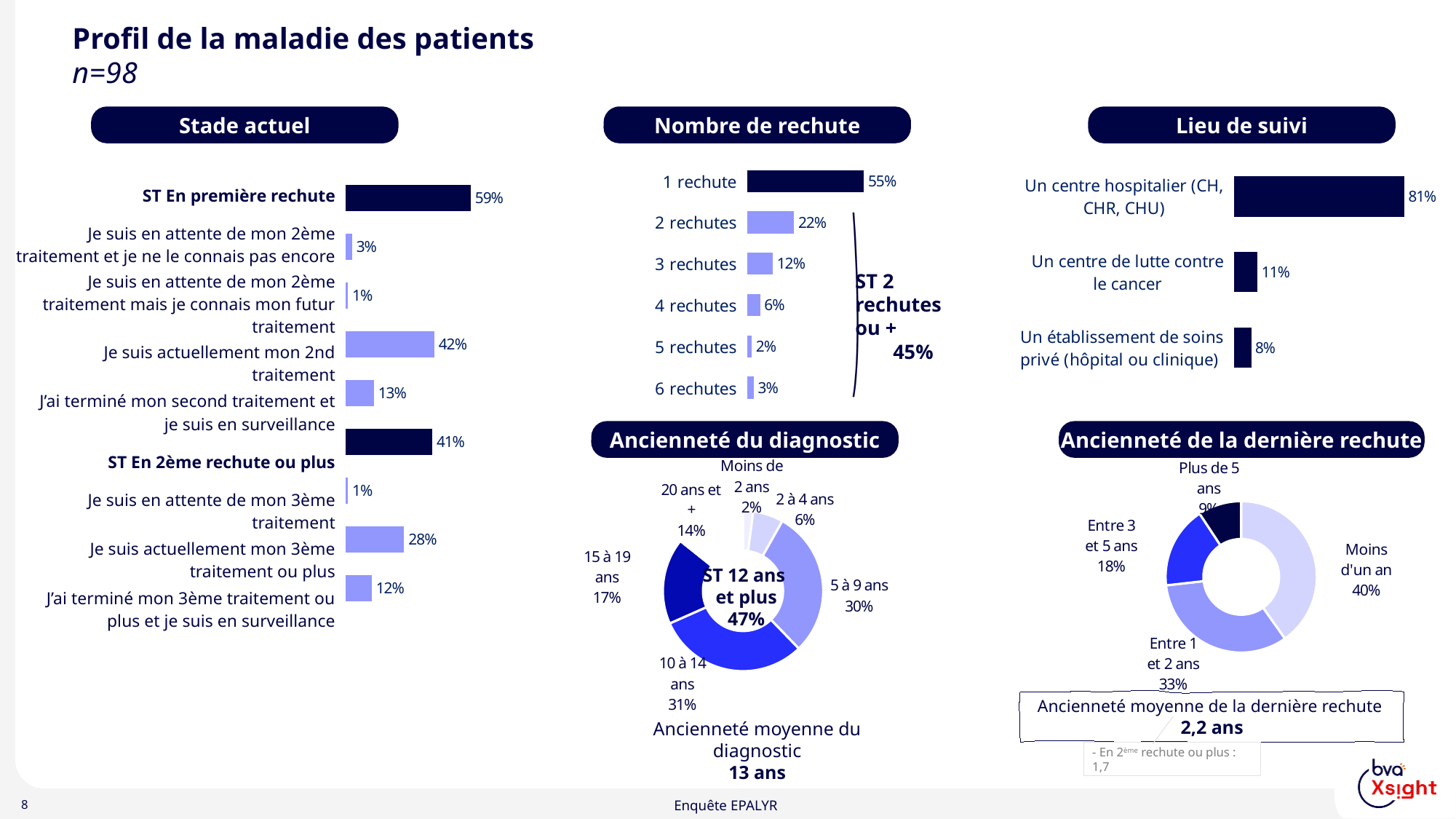
How many categories does the "Nombre de rechute" chart show? 6 In the "Ancienneté du diagnostic" chart, which is larger: the share for "5 à 9 ans" or the share for "10 à 14 ans"? 10 à 14 ans What kind of chart is "Ancienneté de la dernière rechute"? Donut chart In the "Nombre de rechute" chart, which category has the lowest value? 5 rechutes In the "Lieu de suivi" chart, what is the value for "Un centre de lutte contre le cancer"? 11% In the "Nombre de rechute" chart, what is the difference between the values for 1 rechute and 2 rechutes? 33% In the "Stade actuel" chart, what is the value for "Je suis actuellement mon 2nd traitement"? 42% In the "Nombre de rechute" chart, what percentage of patients had 1 rechute? 55% In the "Lieu de suivi" chart, which category has the highest value? Un centre hospitalier (CH, CHR, CHU) In the "Ancienneté du diagnostic" chart, what is the combined share of "15 à 19 ans" and "20 ans et +"? 31% In the "Ancienneté de la dernière rechute" chart, what share of the pie is "Moins d'un an"? 40% What kind of chart is "Lieu de suivi"? Bar chart